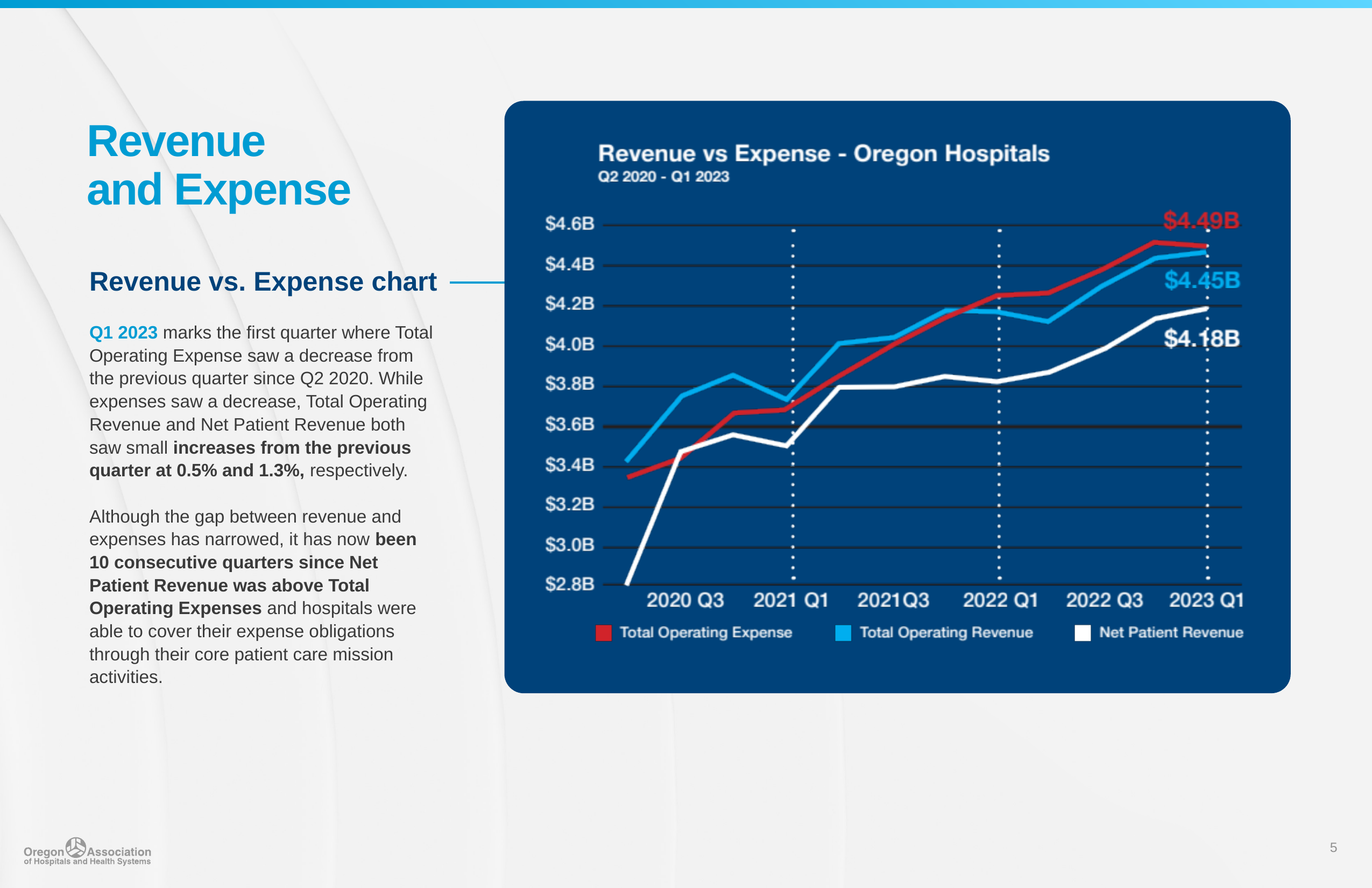
At 2023 Q1, which is larger: Total Operating Expense or Total Operating Revenue? Total Operating Expense How many series does the chart's legend list? 3 What is the title of the chart? Revenue vs Expense - Oregon Hospitals Is the value for Net Patient Revenue at the first point of the series (Q2 2020) greater or less than $3.0B? less What is the value of Total Operating Expense at 2023 Q1? $4.49B Does Net Patient Revenue generally rise or fall from Q2 2020 to Q1 2023? Rise What is the value of Net Patient Revenue at 2023 Q1? $4.18B Which series has the lowest value at 2023 Q1? Net Patient Revenue At 2023 Q1, how much higher is Total Operating Expense than Total Operating Revenue? $0.04B At 2023 Q1, what is the difference between Total Operating Revenue and Net Patient Revenue? $0.27B What kind of chart is shown on the slide? Line chart What is the value of Total Operating Revenue at 2023 Q1? $4.45B